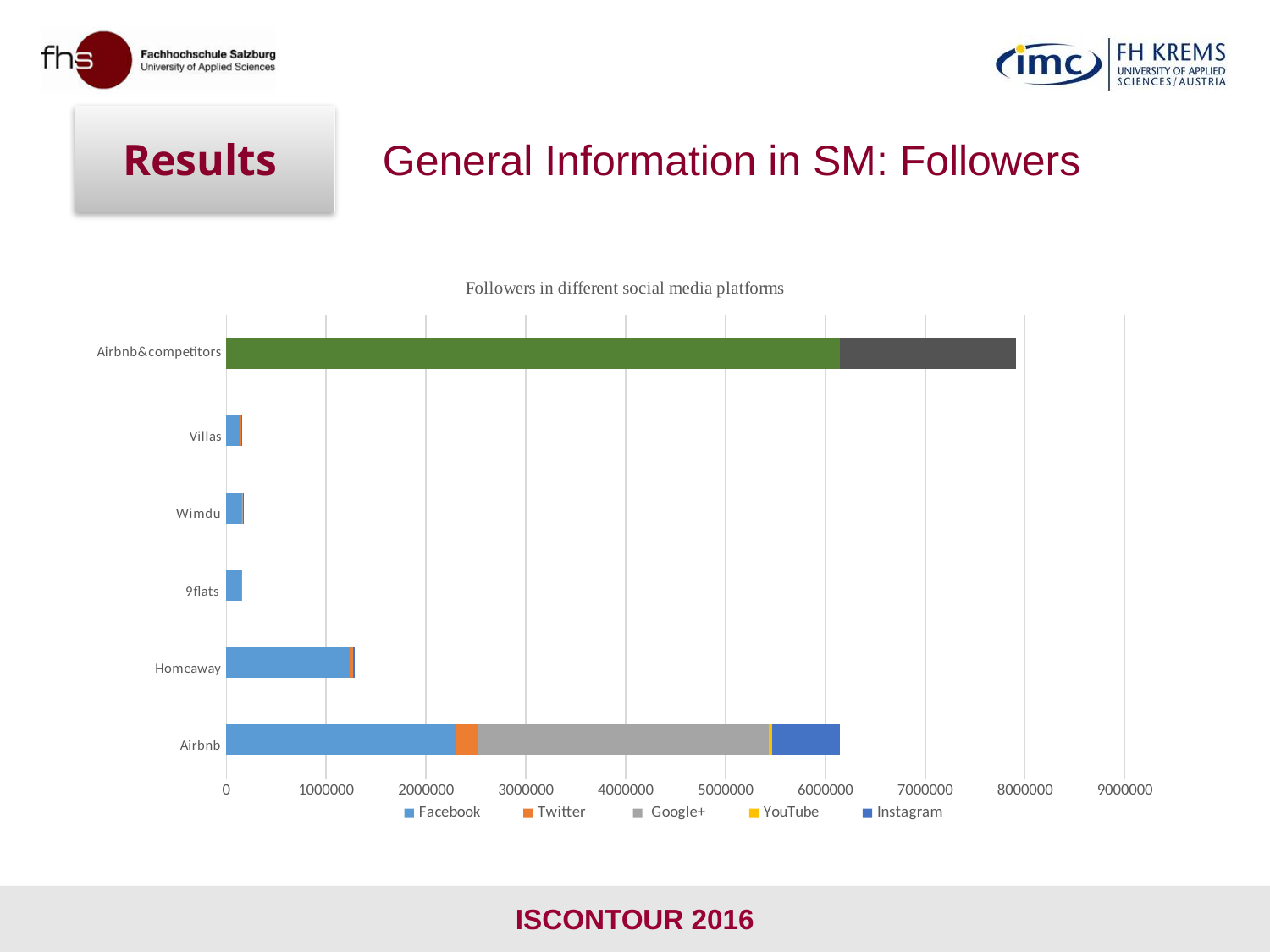
Which has a longer total bar, Airbnb or Homeaway? Airbnb What is the title of the chart? Followers in different social media platforms What kind of chart is shown on the slide? bar chart How many series does the chart legend list? 5 Is the total bar for Homeaway greater or less than 1000000? greater Is the total bar for Airbnb greater or less than 5000000? greater Which series is shown in grey in the chart legend? Google+ Which category has the longest total bar in the chart? Airbnb&competitors Is the total bar for Villas greater or less than 1000000? less How many categories are plotted on the vertical axis of the chart? 6 Which has a longer total bar, Homeaway or Wimdu? Homeaway